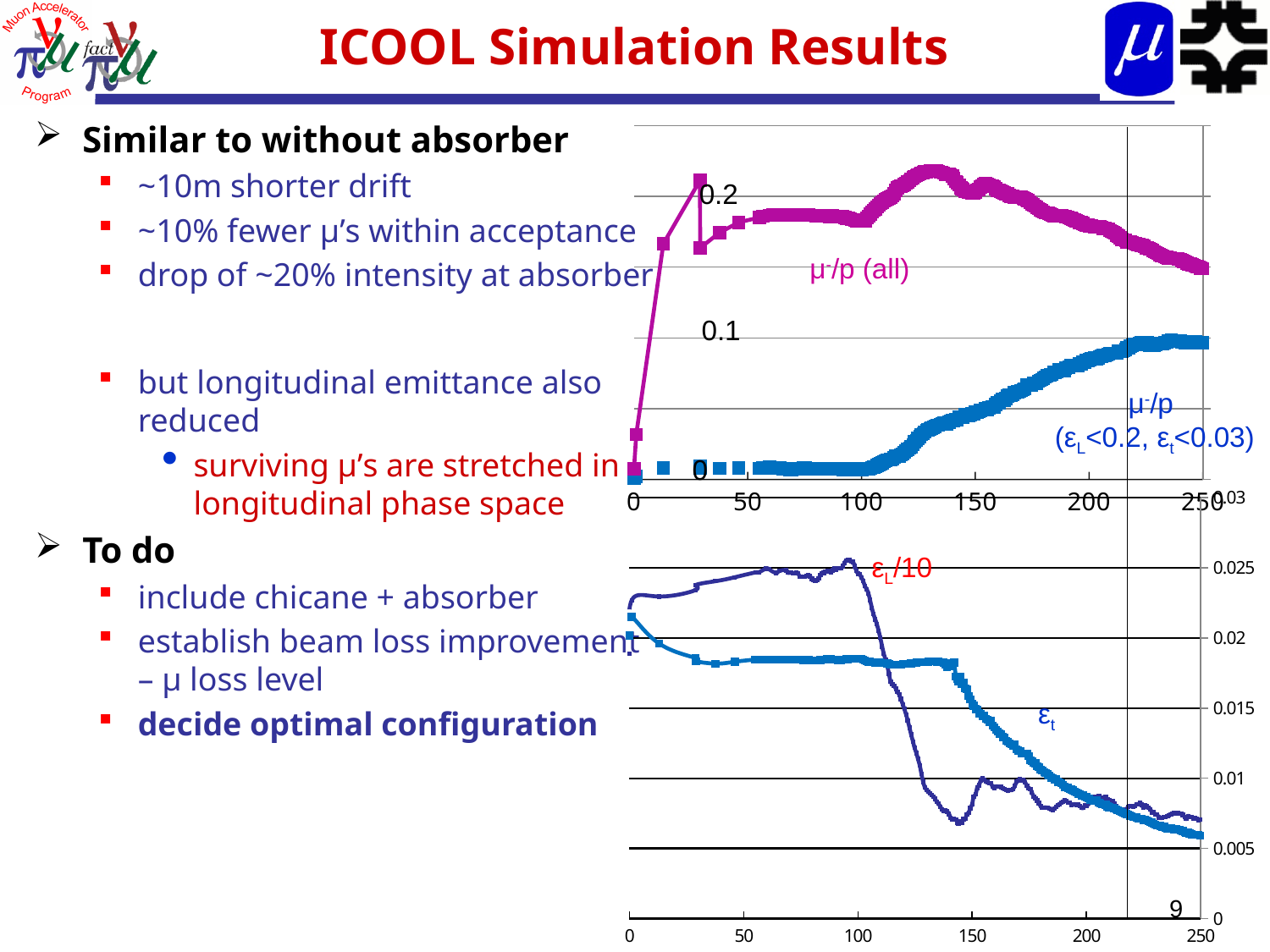
In the top chart, does the μ⁻/p (εL<0.2, εt<0.03) series generally rise or fall as x increases from 100 to 250? rise What is the highest value shown on the x axis of the bottom chart? 250 What kind of chart is the top chart on the slide? line chart In the top chart, is the value of μ⁻/p (all) at x = 250 greater or less than 0.1? greater In the top chart, is the value of μ⁻/p (εL<0.2, εt<0.03) at x = 100 greater or less than 0.1? less In the bottom chart, at x = 50, which series has the higher value: εL/10 or εt? εL/10 In the bottom chart, is the value of εt at x = 250 greater or less than 0.01? less How many data series are plotted in the bottom chart? 2 In the top chart, at x = 250, which series has the higher value: μ⁻/p (all) or μ⁻/p (εL<0.2, εt<0.03)? μ⁻/p (all) In the bottom chart, does the εt series generally rise or fall as x increases? fall How many data series are plotted in the top chart? 2